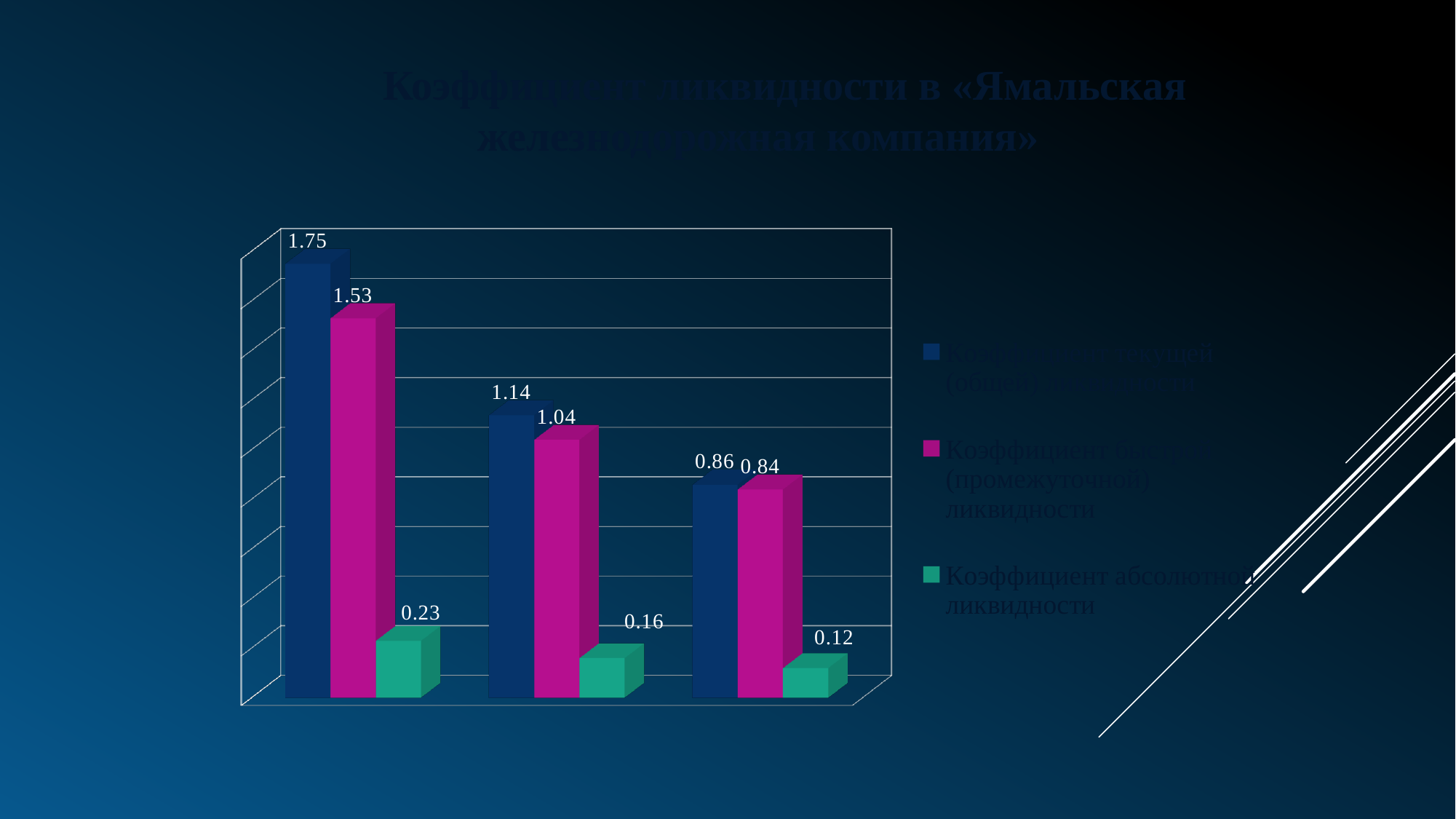
What colour is the series labelled Коэффициент абсолютной ликвидности in the legend? green What is the value of the green bar (Коэффициент абсолютной ликвидности) in the third (rightmost) group? 0.12 Do the values of the magenta series rise or fall from the first group to the third group? fall How many series does the legend list? 3 Which group has the lowest value for the dark blue series? the third (rightmost) group Which is larger in the second group: the dark blue bar (1.14) or the magenta bar (1.04)? the dark blue bar How many groups of bars are plotted along the x axis? 3 What is the value of the dark blue bar in the first (leftmost) group? 1.75 What kind of chart is shown on the slide? bar chart What is the difference between the dark blue bar and the magenta bar in the first group? 0.22 What is the value of the magenta bar (Коэффициент быстрой (промежуточной) ликвидности) in the second group? 1.04 Which group has the highest value for the green series (Коэффициент абсолютной ликвидности)? the first (leftmost) group